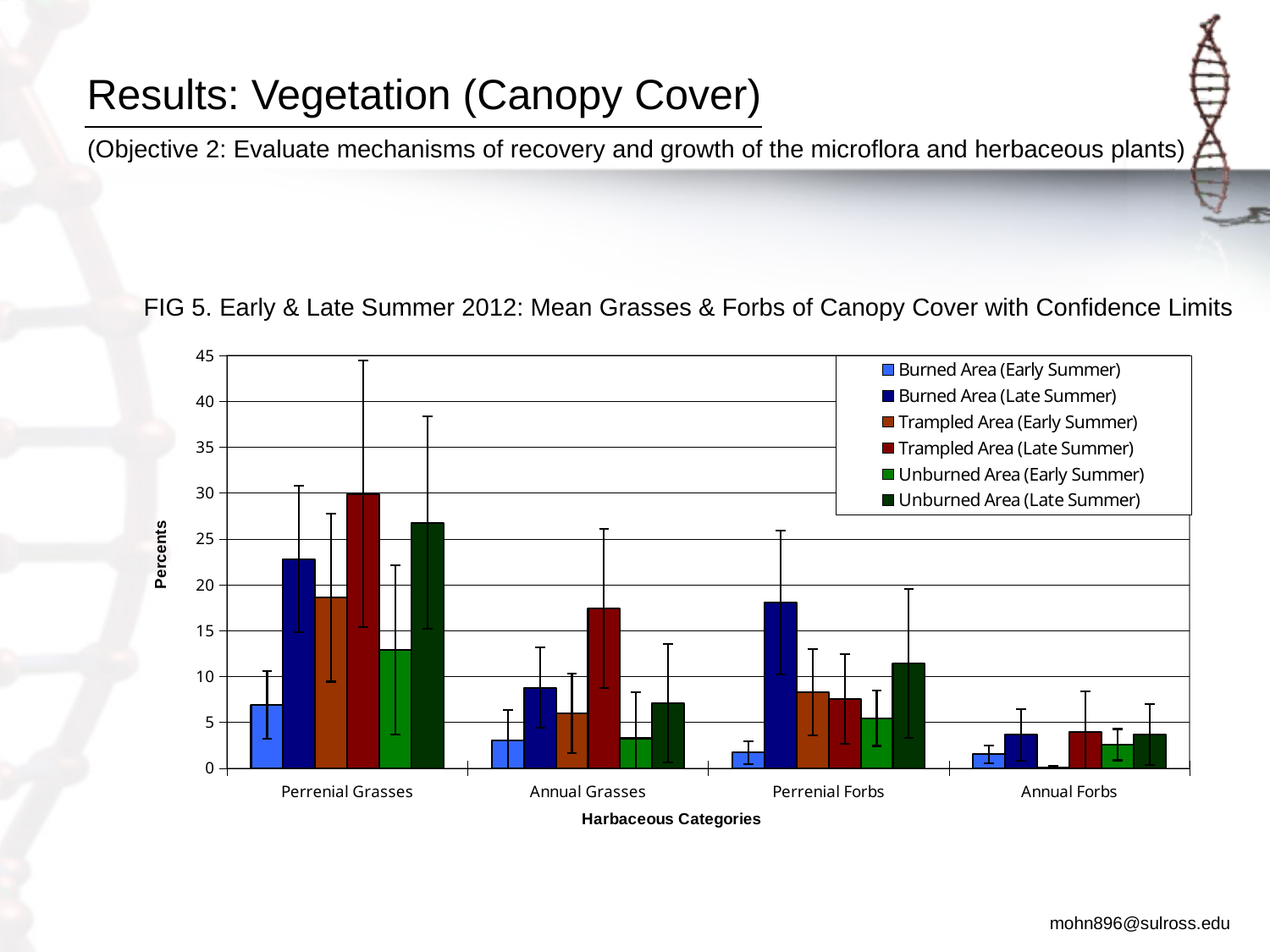
In which herbaceous category is the Trampled Area (Early Summer) bar the lowest? Annual Forbs How many series does the legend of the chart list? 6 Is the Trampled Area (Late Summer) value for Perrenial Grasses greater or less than 25? greater What is the title of the vertical axis of the chart? Percents What kind of chart is shown in FIG 5? bar chart Is the Burned Area (Late Summer) value for Perrenial Forbs greater or less than 15? greater In which herbaceous category is the Trampled Area (Late Summer) bar the highest? Perrenial Grasses For Perrenial Grasses, which is larger: Burned Area (Early Summer) or Burned Area (Late Summer)? Burned Area (Late Summer) Which series has the highest bar in the Perrenial Forbs category? Burned Area (Late Summer) How many herbaceous categories are shown on the x axis of the chart? 4 For Annual Grasses, which is larger: Trampled Area (Late Summer) or Unburned Area (Late Summer)? Trampled Area (Late Summer) Is the Burned Area (Early Summer) value for Perrenial Grasses greater or less than 10? less